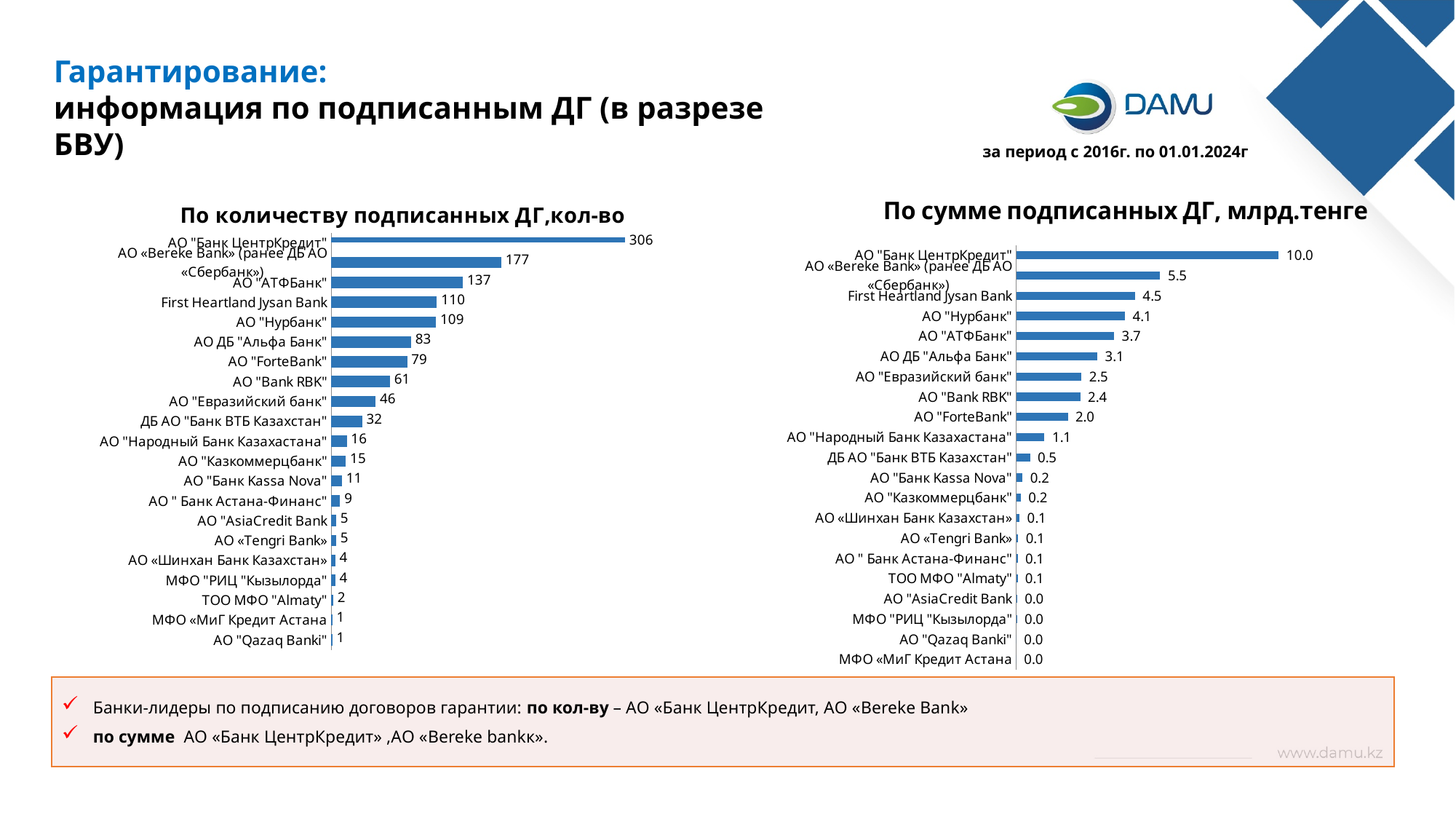
In the chart "По сумме подписанных ДГ, млрд.тенге", what is the difference between АО "Банк ЦентрКредит" and АО «Bereke Bank» (ранее ДБ АО «Сбербанк»)? 4.5 In the chart "По сумме подписанных ДГ, млрд.тенге", what is the value for АО "Нурбанк"? 4.1 In the chart "По количеству подписанных ДГ,кол-во", which bank has the highest value? АО "Банк ЦентрКредит" In the chart "По количеству подписанных ДГ,кол-во", what is the value for АО "Банк ЦентрКредит"? 306 In the chart "По количеству подписанных ДГ,кол-во", which is larger: АО ДБ "Альфа Банк" or АО "Bank RBK"? АО ДБ "Альфа Банк" In the chart "По количеству подписанных ДГ,кол-во", what is the difference between АО "АТФБанк" and First Heartland Jysan Bank? 27 How many banks are listed in the chart "По количеству подписанных ДГ,кол-во"? 21 In the chart "По сумме подписанных ДГ, млрд.тенге", what is the value for АО "Народный Банк Казахастана"? 1.1 In the chart "По количеству подписанных ДГ,кол-во", what is the value for АО "ForteBank"? 79 What is the title of the chart on the left side of the slide? По количеству подписанных ДГ,кол-во What type of chart is "По сумме подписанных ДГ, млрд.тенге"? Bar chart In the chart "По сумме подписанных ДГ, млрд.тенге", which is larger: АО "Евразийский банк" or АО "ForteBank"? АО "Евразийский банк"